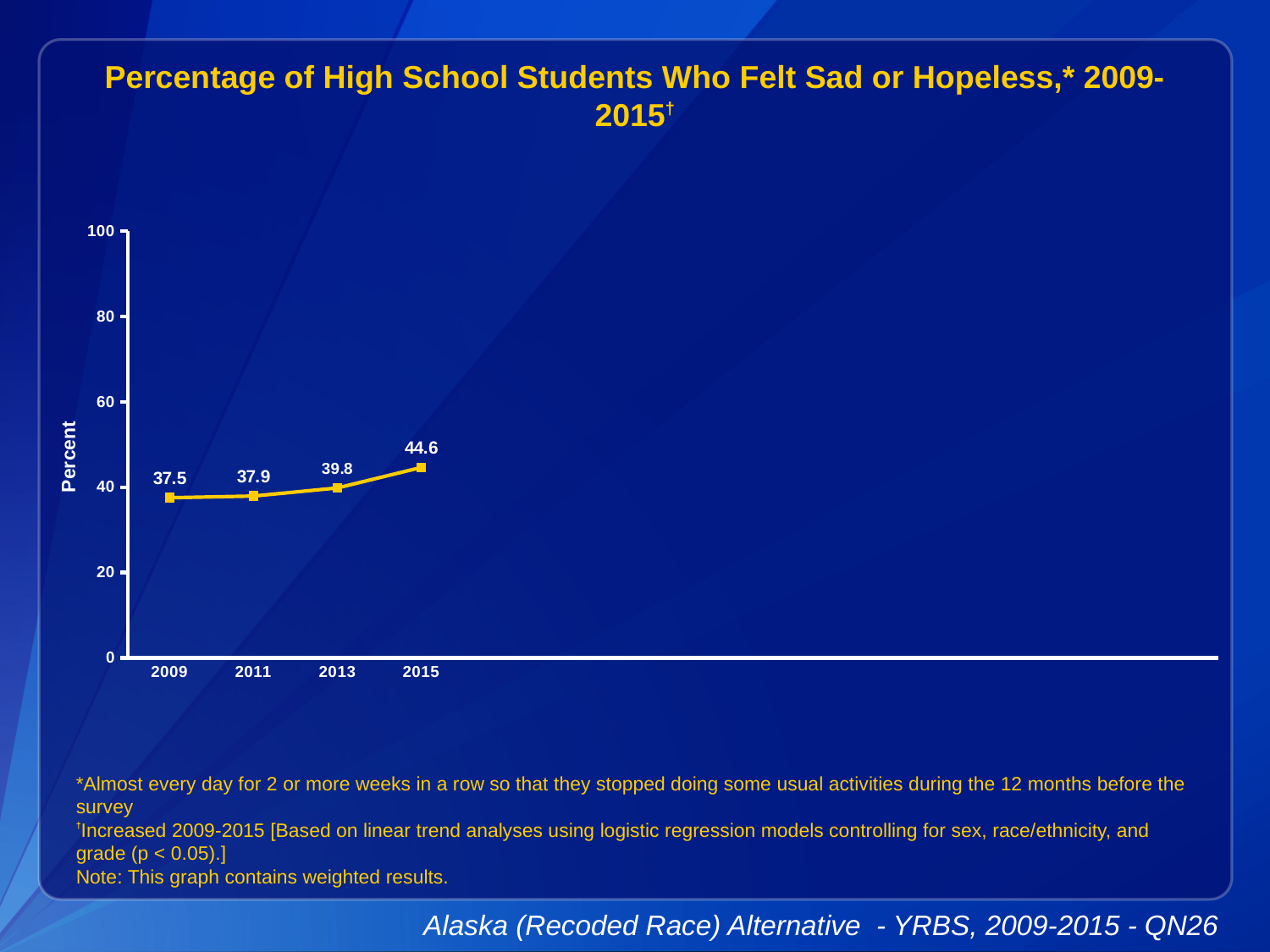
Is the value for 2015 greater or less than 40? greater What is the value plotted for 2013? 39.8 What is the difference between the 2015 value and the 2009 value? 7.1 What is the label on the vertical axis of the chart? Percent Do the values rise or fall from 2009 to 2015? Rise Which year has the highest percentage of students who felt sad or hopeless? 2015 What is the value plotted for 2015? 44.6 Which year has a larger value, 2011 or 2013? 2013 What percentage of high school students felt sad or hopeless in 2009? 37.5 Which year has the lowest percentage of students who felt sad or hopeless? 2009 How many years are plotted on the chart? 4 What kind of chart is shown on the slide? Line chart